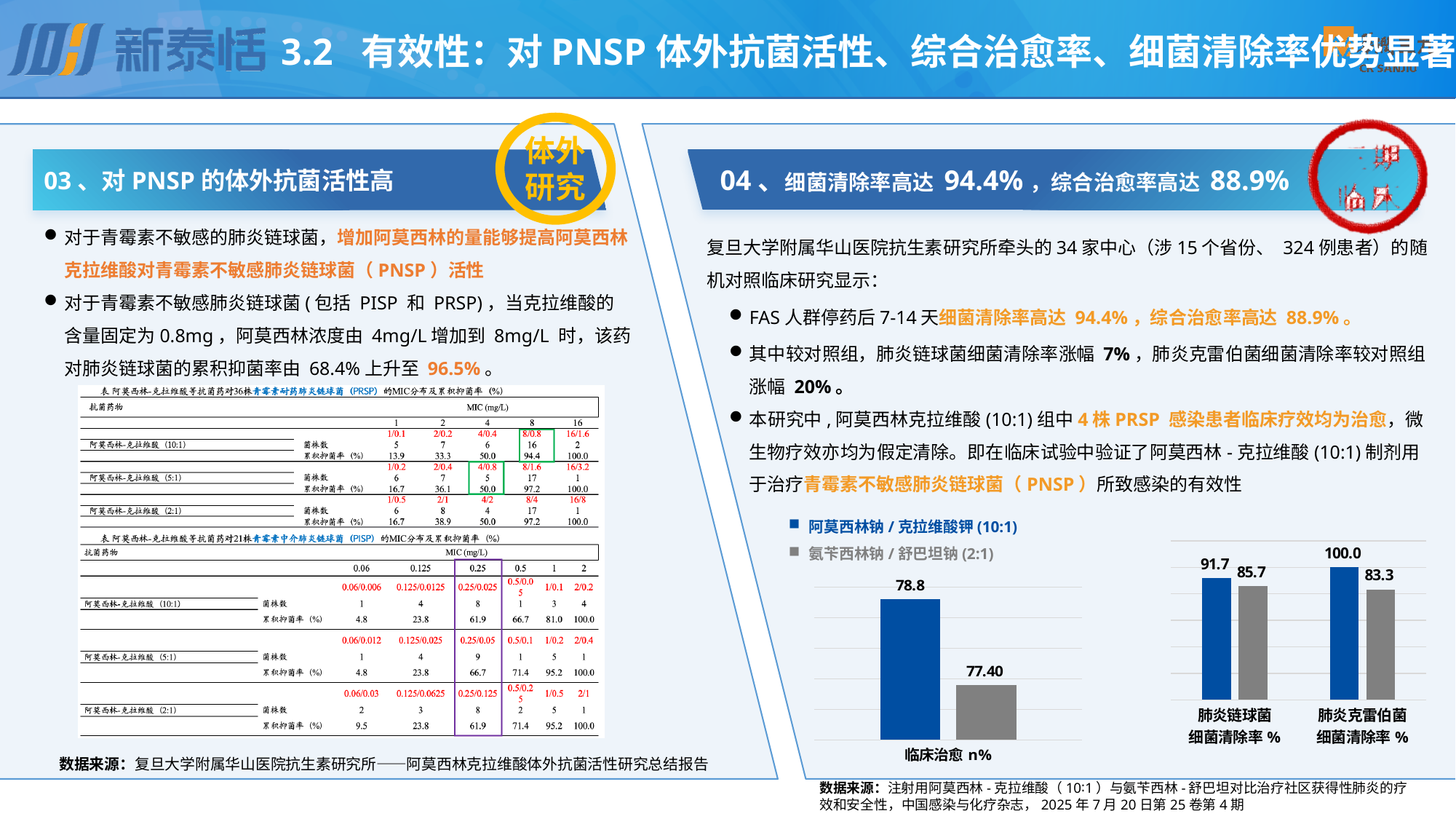
In the right bar chart, what is the difference between the two series for 肺炎克雷伯菌细菌清除率? 16.7 In the right bar chart, what is the 肺炎克雷伯菌细菌清除率 for 氨苄西林钠/舒巴坦钠 (2:1)? 83.3 In the left bar chart (临床治愈 n%), what is the value for 氨苄西林钠/舒巴坦钠 (2:1)? 77.40 In the right bar chart, what is the 肺炎克雷伯菌细菌清除率 for 阿莫西林钠/克拉维酸钾 (10:1)? 100.0 What kind of chart is the chart labelled 临床治愈 n%? bar chart In the right bar chart, which bar has the highest value? 肺炎克雷伯菌细菌清除率 for 阿莫西林钠/克拉维酸钾 (10:1) In the right bar chart, which series has the larger 肺炎链球菌细菌清除率, 阿莫西林钠/克拉维酸钾 (10:1) or 氨苄西林钠/舒巴坦钠 (2:1)? 阿莫西林钠/克拉维酸钾 (10:1) In the right bar chart, what is the difference between the two series for 肺炎链球菌细菌清除率? 6.0 In the left bar chart (临床治愈 n%), what is the value for 阿莫西林钠/克拉维酸钾 (10:1)? 78.8 In the right bar chart, what is the 肺炎链球菌细菌清除率 for 阿莫西林钠/克拉维酸钾 (10:1)? 91.7 How many series does the legend above the bar charts list? 2 In the right bar chart, which bar has the lowest value? 肺炎克雷伯菌细菌清除率 for 氨苄西林钠/舒巴坦钠 (2:1)